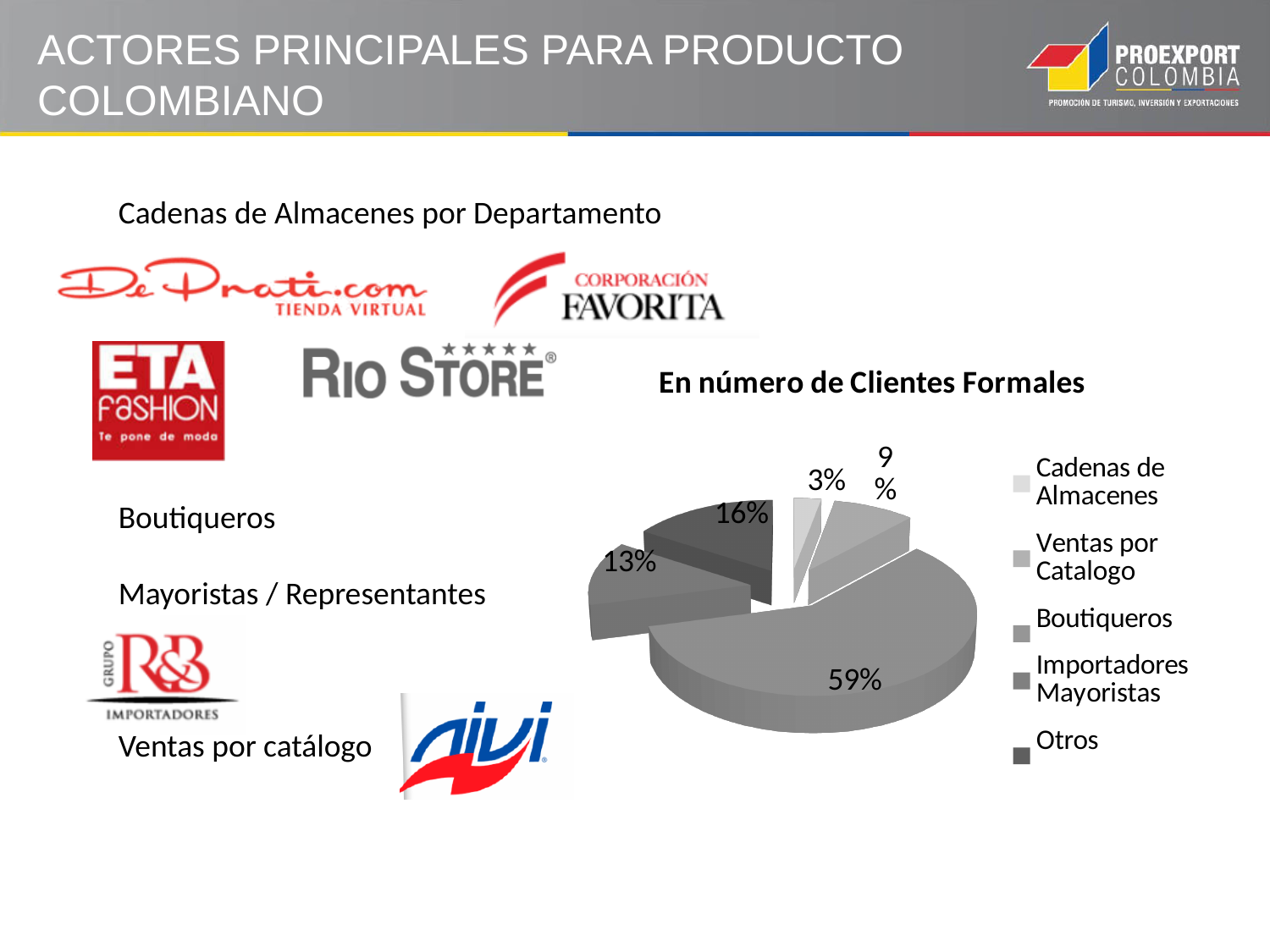
What share of the pie does Importadores Mayoristas represent? 13% How many categories does the chart's legend list? 5 What type of chart is shown on the slide? pie chart What is the title of the chart? En número de Clientes Formales What share of the pie does Ventas por Catalogo represent? 9% Which category has the largest share of the pie? Boutiqueros What share of the pie does Otros represent? 16% Which has a larger share, Ventas por Catalogo or Importadores Mayoristas? Importadores Mayoristas Which category has the smallest share of the pie? Cadenas de Almacenes What is the difference in percentage points between Otros and Importadores Mayoristas? 3